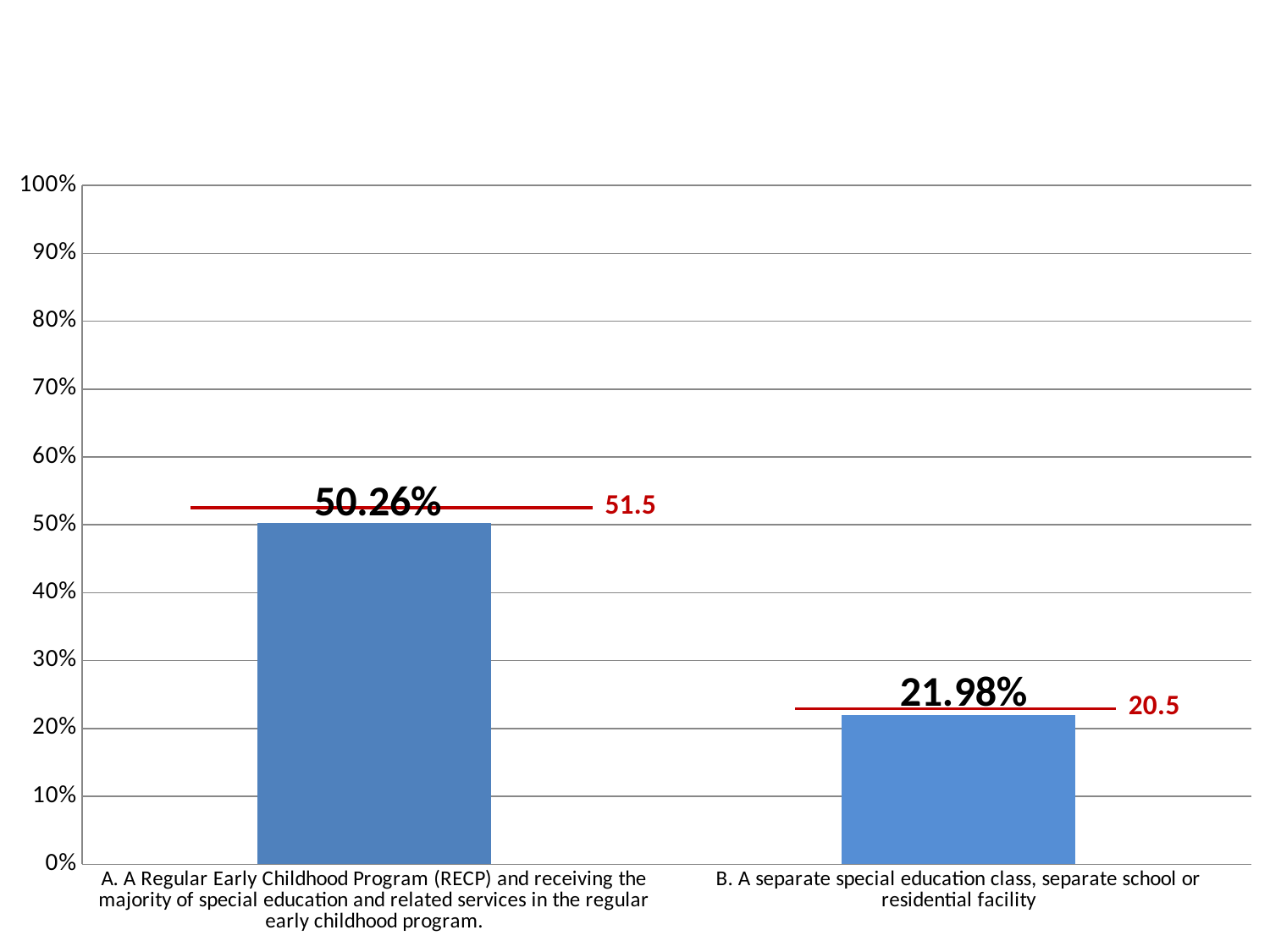
Which category has the highest value? A. A Regular Early Childhood Program (RECP) and receiving the majority of special education and related services in the regular early childhood program. What is the value for category B (A separate special education class, separate school or residential facility)? 21.98% Which category has the lowest value? B. A separate special education class, separate school or residential facility What is the red target line value shown next to the bar for category A? 51.5 What is the value for category A (A Regular Early Childhood Program (RECP) and receiving the majority of special education and related services in the regular early childhood program)? 50.26% What is the difference between the values for category A and category B? 28.28% Is the value for category B greater or less than 30%? less Is the value for category A greater or less than 40%? greater Which is larger, the value for category A or the value for category B? Category A How many categories are shown in the chart? 2 What kind of chart is shown on the slide? Bar chart What is the red target line value shown next to the bar for category B? 20.5